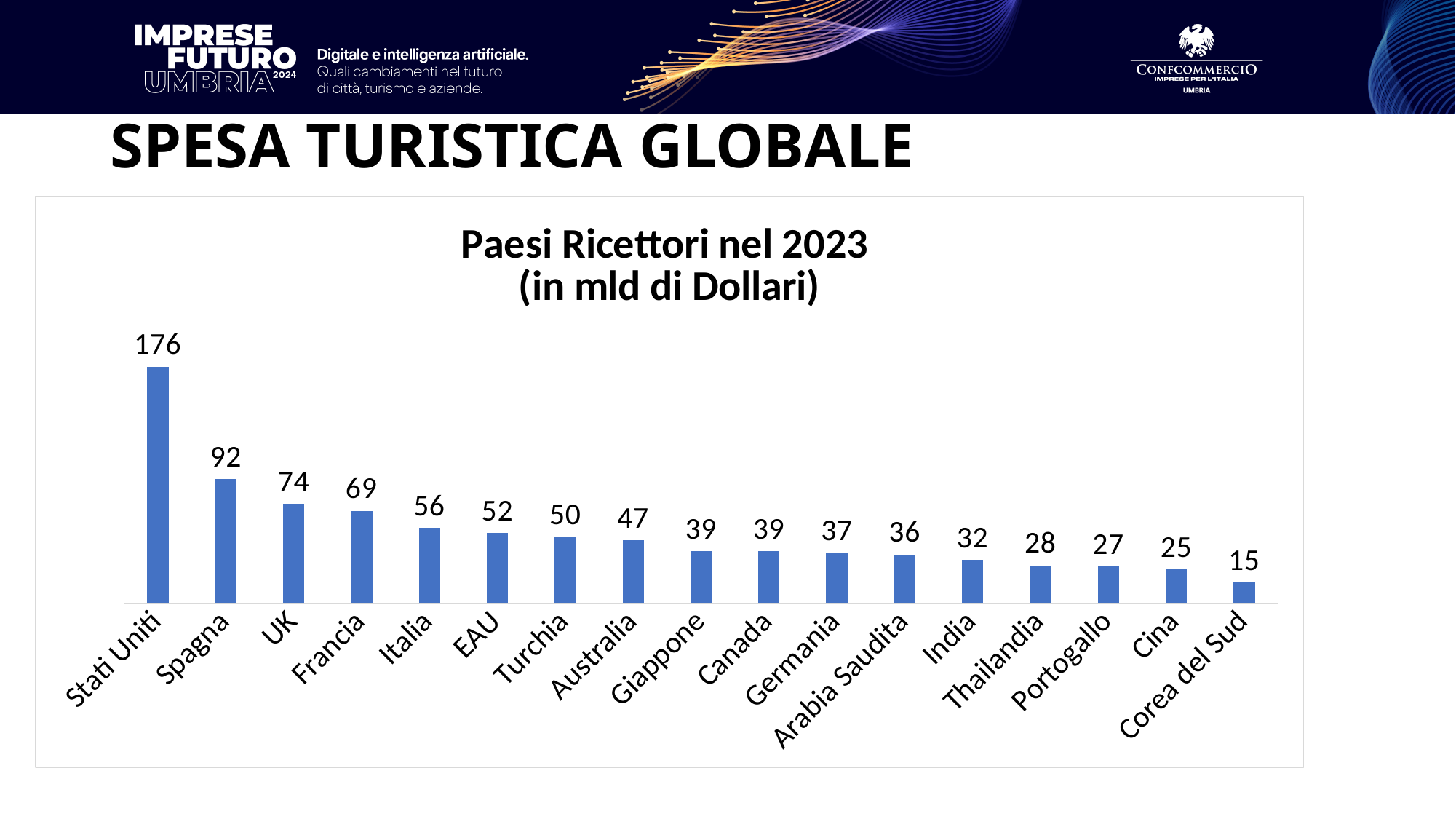
What is the value for Arabia Saudita? 36 How many countries are shown in the chart? 17 What is the difference between the values for Stati Uniti and Corea del Sud? 161 What is the difference between the values for Spagna and UK? 18 Which country has the highest value? Stati Uniti What is the value for Italia? 56 Which has a larger value, Francia or Turchia? Francia What is the title of the chart? Paesi Ricettori nel 2023 (in mld di Dollari) Which has a larger value, Cina or India? India What kind of chart is shown? Bar chart Which country has the lowest value? Corea del Sud What is the value for Stati Uniti? 176